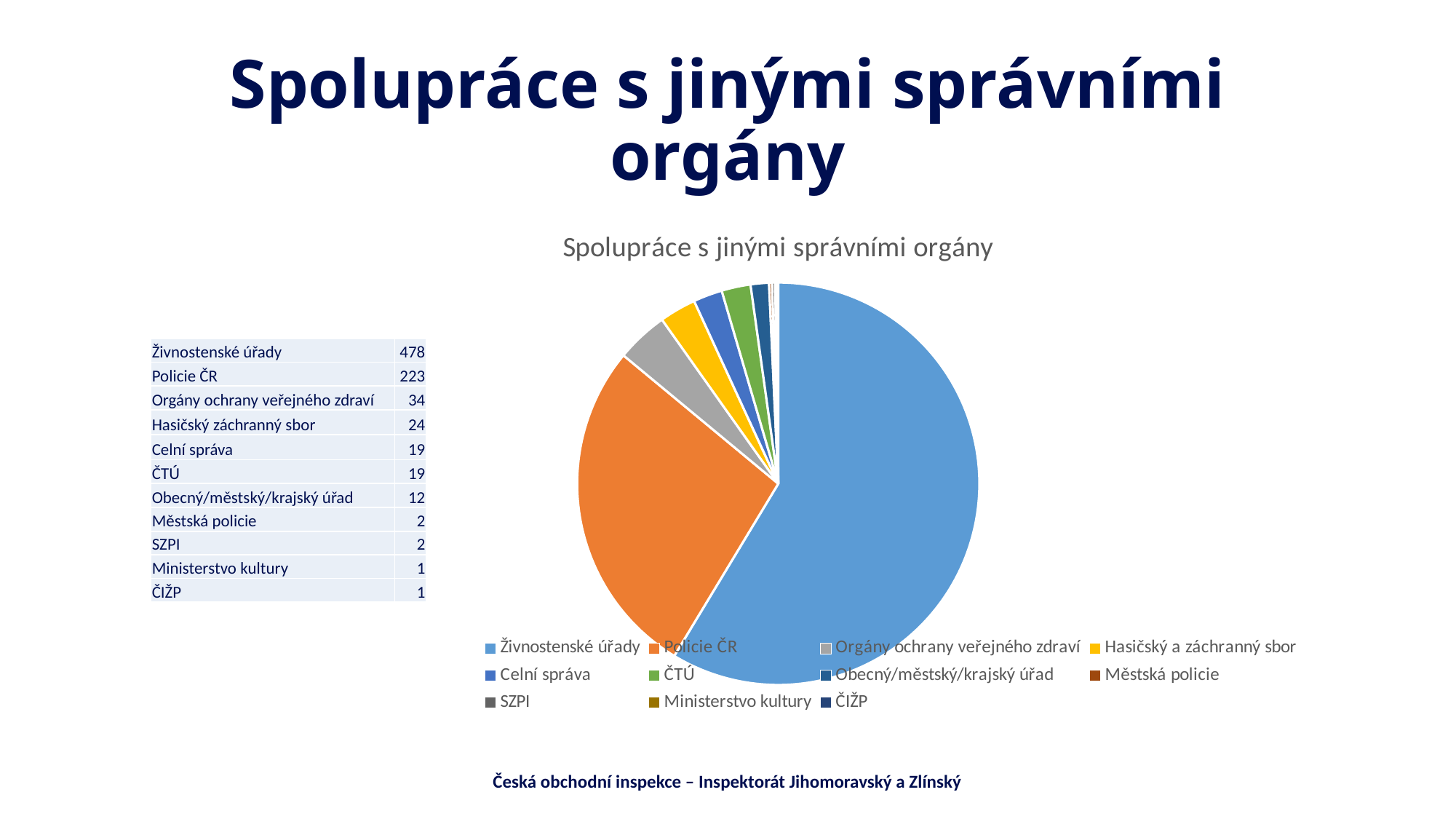
What is the value for Obecný/městský/krajský úřad? 12 What is the value for Živnostenské úřady? 478 What is the value for Policie ČR? 223 How many categories does the pie chart contain? 11 Which is larger, the value for Orgány ochrany veřejného zdraví or for Hasičský záchranný sbor? Orgány ochrany veřejného zdraví What is the total of all the values shown in the table? 815 How many entries does the legend list? 11 What colour is the Policie ČR slice? Orange Which categories have the smallest value? Ministerstvo kultury and ČIŽP (1 each) Which category has the largest slice of the pie? Živnostenské úřady What is the difference between the values for Živnostenské úřady and Policie ČR? 255 What kind of chart is shown on the slide? Pie chart